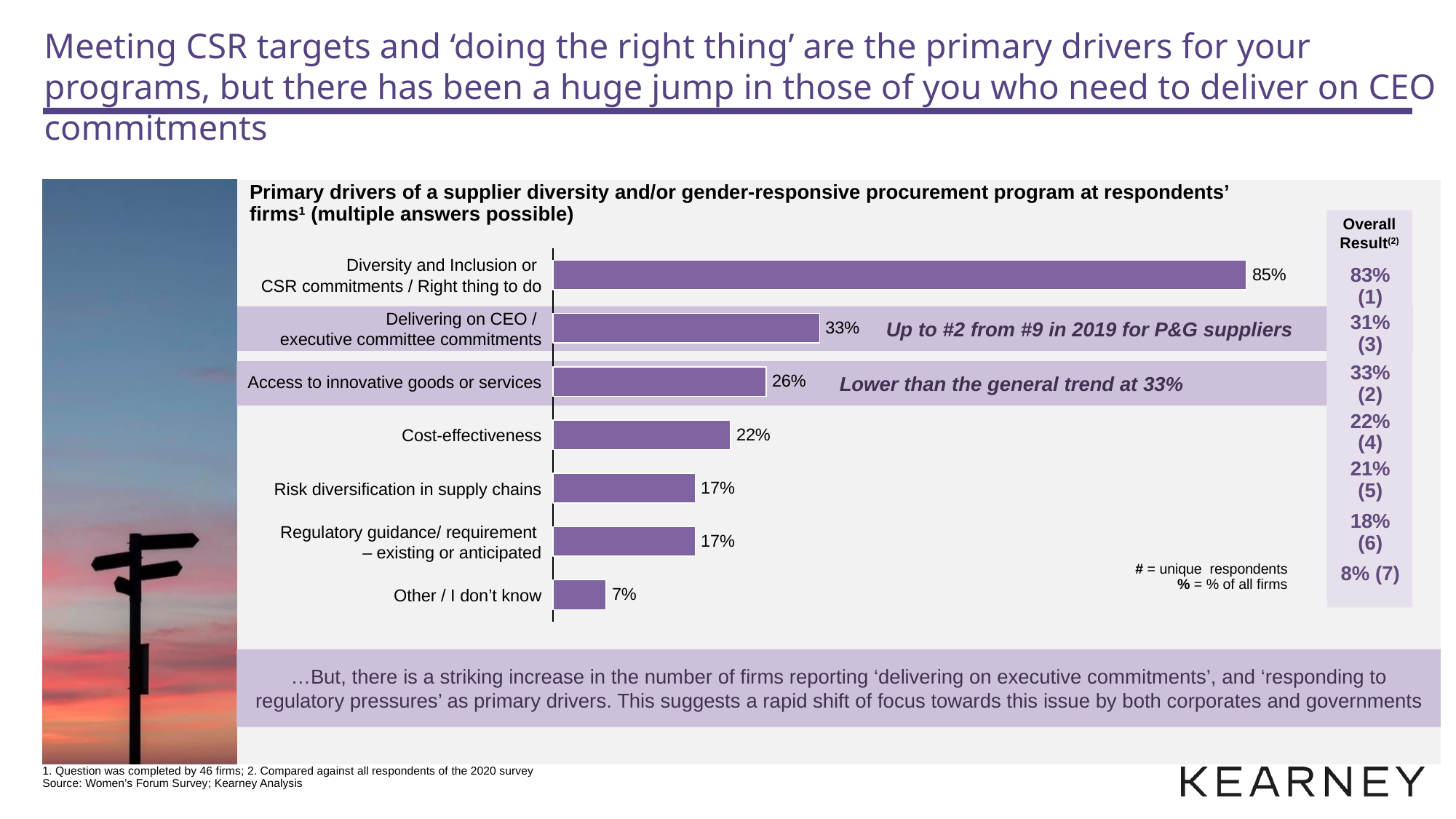
What kind of chart is shown on the slide? Bar chart What is the value for 'Diversity and Inclusion or CSR commitments / Right thing to do'? 85% What is the difference between the values for 'Diversity and Inclusion or CSR commitments / Right thing to do' and 'Delivering on CEO / executive committee commitments'? 52% What is the value for 'Other / I don't know'? 7% What is the title of the chart? Primary drivers of a supplier diversity and/or gender-responsive procurement program at respondents' firms (multiple answers possible) What is the value for 'Delivering on CEO / executive committee commitments'? 33% How many categories are shown in the chart? 7 Which category has the lowest value? Other / I don't know What is the value for 'Access to innovative goods or services'? 26% What is the value for 'Cost-effectiveness'? 22% Which is larger: the value for 'Access to innovative goods or services' or the value for 'Cost-effectiveness'? Access to innovative goods or services Which category has the highest value? Diversity and Inclusion or CSR commitments / Right thing to do